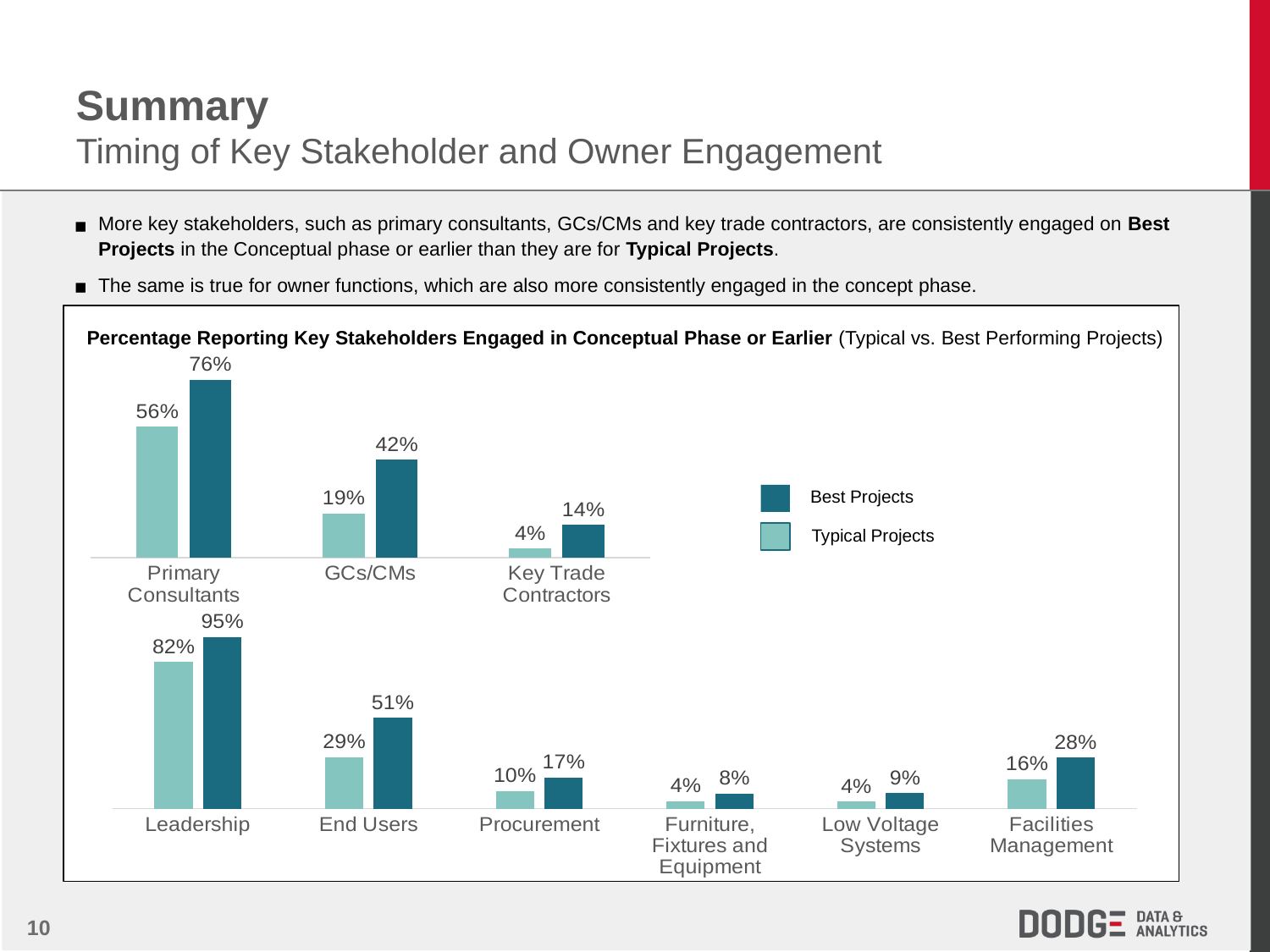
In the bottom chart, what is the difference between the Best Projects and Typical Projects values for Leadership? 13% In the top chart, what is the difference between the Best Projects and Typical Projects values for GCs/CMs? 23% How many categories are shown in the bottom chart? 6 What type of chart is used on this slide? Bar chart In the top chart, what is the value for Typical Projects for GCs/CMs? 19% How many series does the legend list? 2 In the bottom chart, what is the value for Best Projects for End Users? 51% In the top chart, what is the value for Best Projects for Primary Consultants? 76% In the top chart, which category has the lowest value for Typical Projects? Key Trade Contractors In the bottom chart, which is larger: the Best Projects value for Procurement or the Best Projects value for Facilities Management? Facilities Management In the bottom chart, what is the value for Typical Projects for Facilities Management? 16% In the bottom chart, which category has the highest value for Best Projects? Leadership